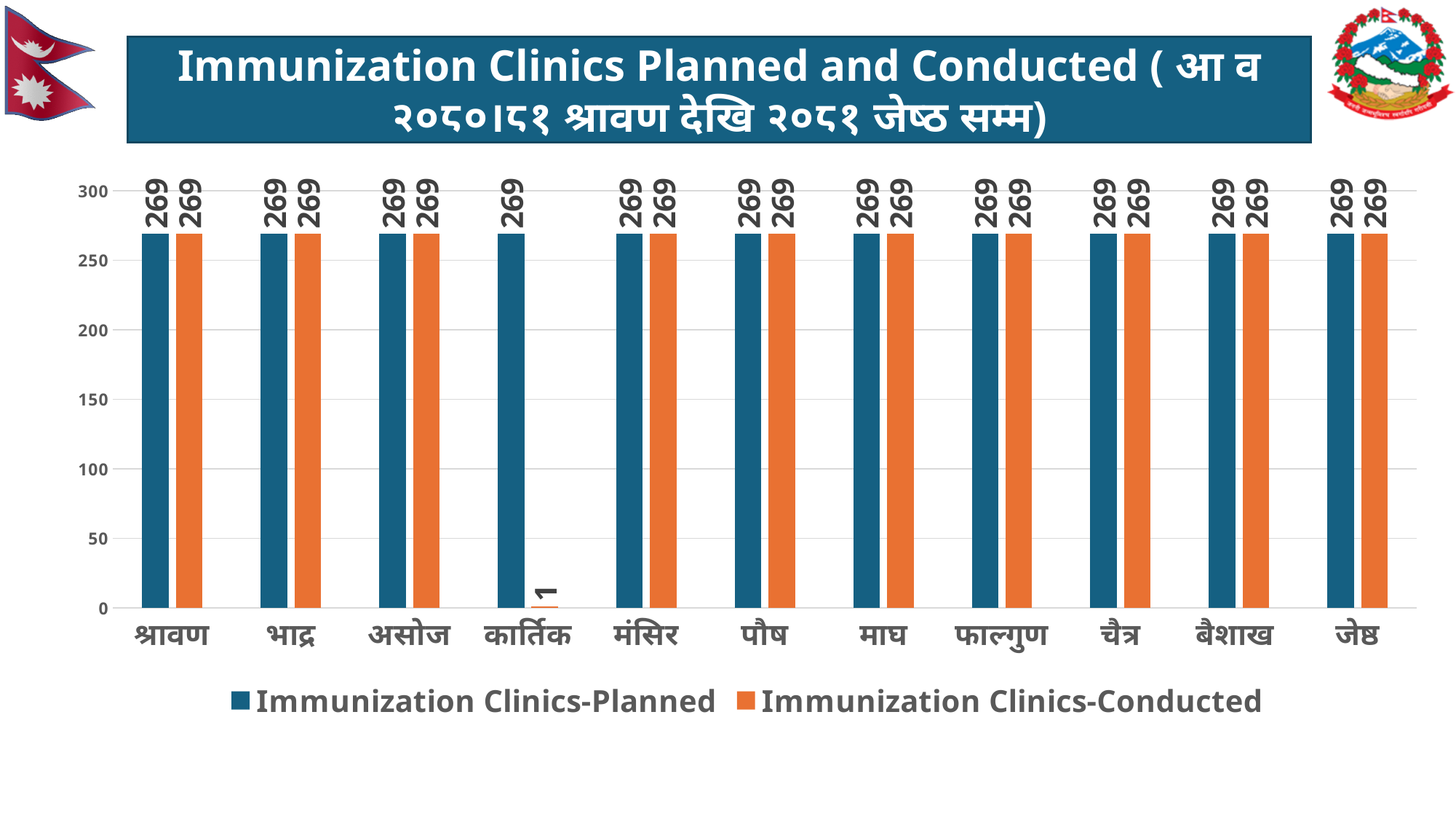
Is the value of Immunization Clinics-Conducted for कार्तिक greater or less than 50? less Which colour represents Immunization Clinics-Conducted in the chart? Orange How many months are shown on the x axis of the chart? 11 What is the difference between Immunization Clinics-Planned and Immunization Clinics-Conducted for कार्तिक? 268 What kind of chart is shown on the slide? Bar chart How many series does the legend list? 2 Which month has the lowest value for Immunization Clinics-Conducted? कार्तिक Is the value of Immunization Clinics-Planned for माघ greater or less than 250? greater For कार्तिक, which is larger: Immunization Clinics-Planned or Immunization Clinics-Conducted? Immunization Clinics-Planned What is the value of Immunization Clinics-Conducted for कार्तिक? 1 What is the value of Immunization Clinics-Planned for श्रावण? 269 What is the value of Immunization Clinics-Conducted for जेष्ठ? 269